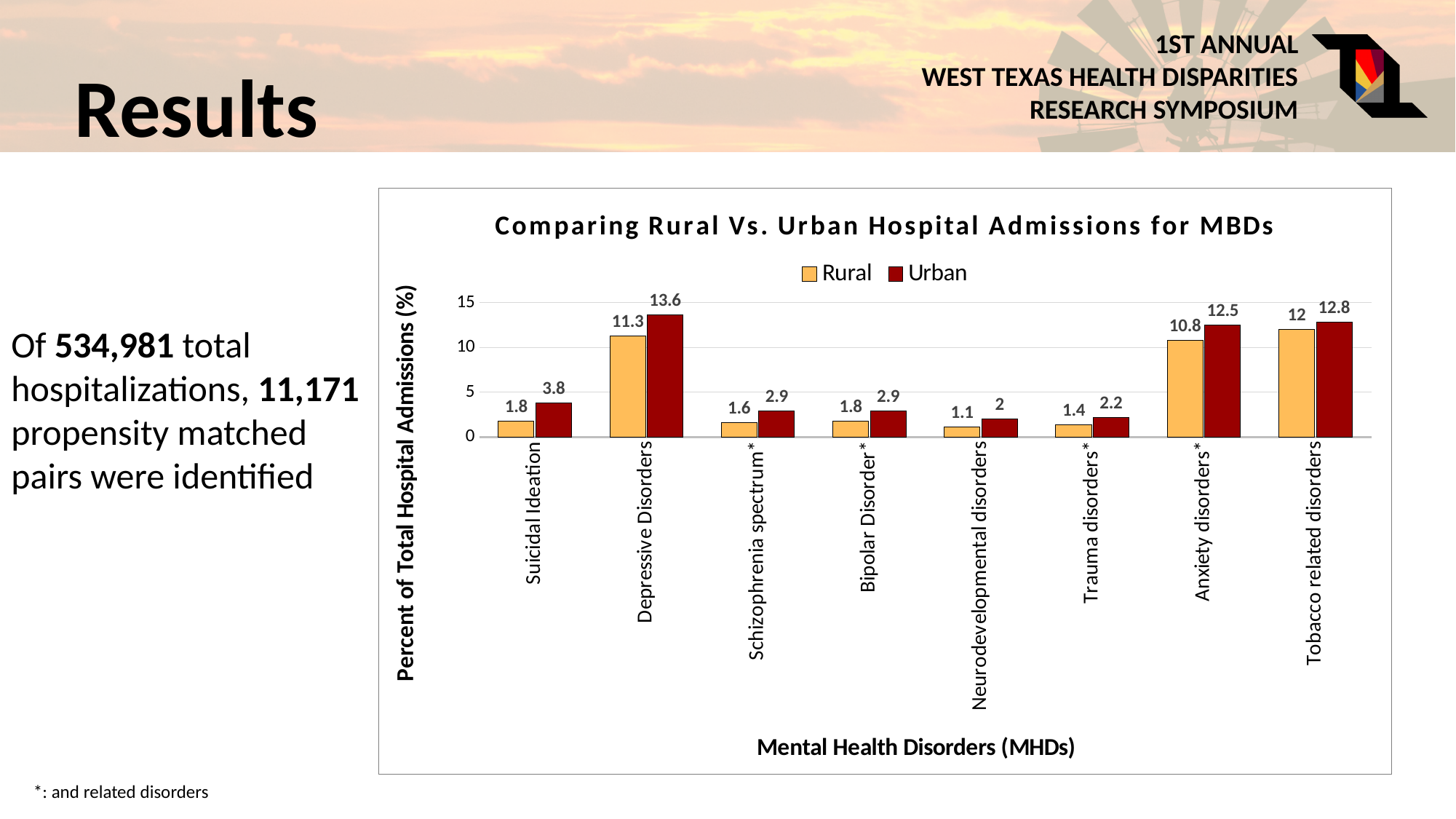
How many series does the legend list? 2 What is the title of the chart? Comparing Rural Vs. Urban Hospital Admissions for MBDs Which category has the lowest Rural value? Neurodevelopmental disorders What is the Rural value for Depressive Disorders? 11.3 How many mental health disorder categories are shown on the x axis? 8 Which category has the highest Urban value? Depressive Disorders What is the difference between the Urban and Rural values for Depressive Disorders? 2.3 Which is larger, the Rural value for Anxiety disorders or the Rural value for Tobacco related disorders? Tobacco related disorders What is the difference between the Urban and Rural values for Suicidal Ideation? 2 What kind of chart is shown on the slide? Bar chart What is the Urban value for Neurodevelopmental disorders? 2 What is the Urban value for Tobacco related disorders? 12.8